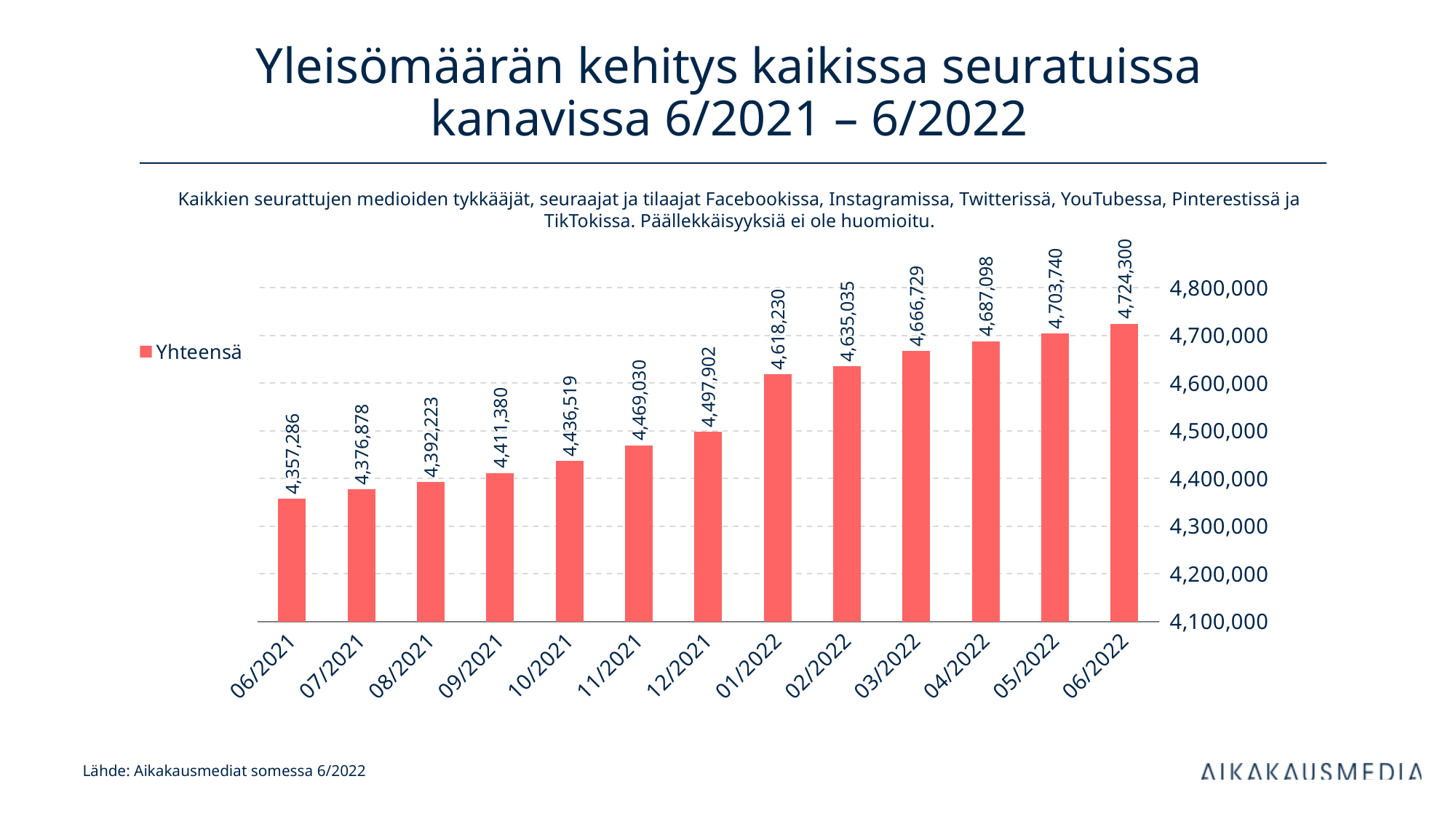
What is the difference between the values for 06/2022 and 06/2021? 367,014 What is the difference between the values for 01/2022 and 12/2021? 120,328 Which is larger, the value for 10/2021 or the value for 03/2022? 03/2022 What is the value for 06/2021? 4,357,286 What is the value for 06/2022? 4,724,300 What is the value for 01/2022? 4,618,230 Is the value for 12/2021 greater or less than 4,500,000? less Do the values rise or fall from 06/2021 to 06/2022? rise Which month has the lowest value? 06/2021 How many months are shown on the x axis? 13 What kind of chart is shown on the slide? bar chart Which month has the highest value? 06/2022